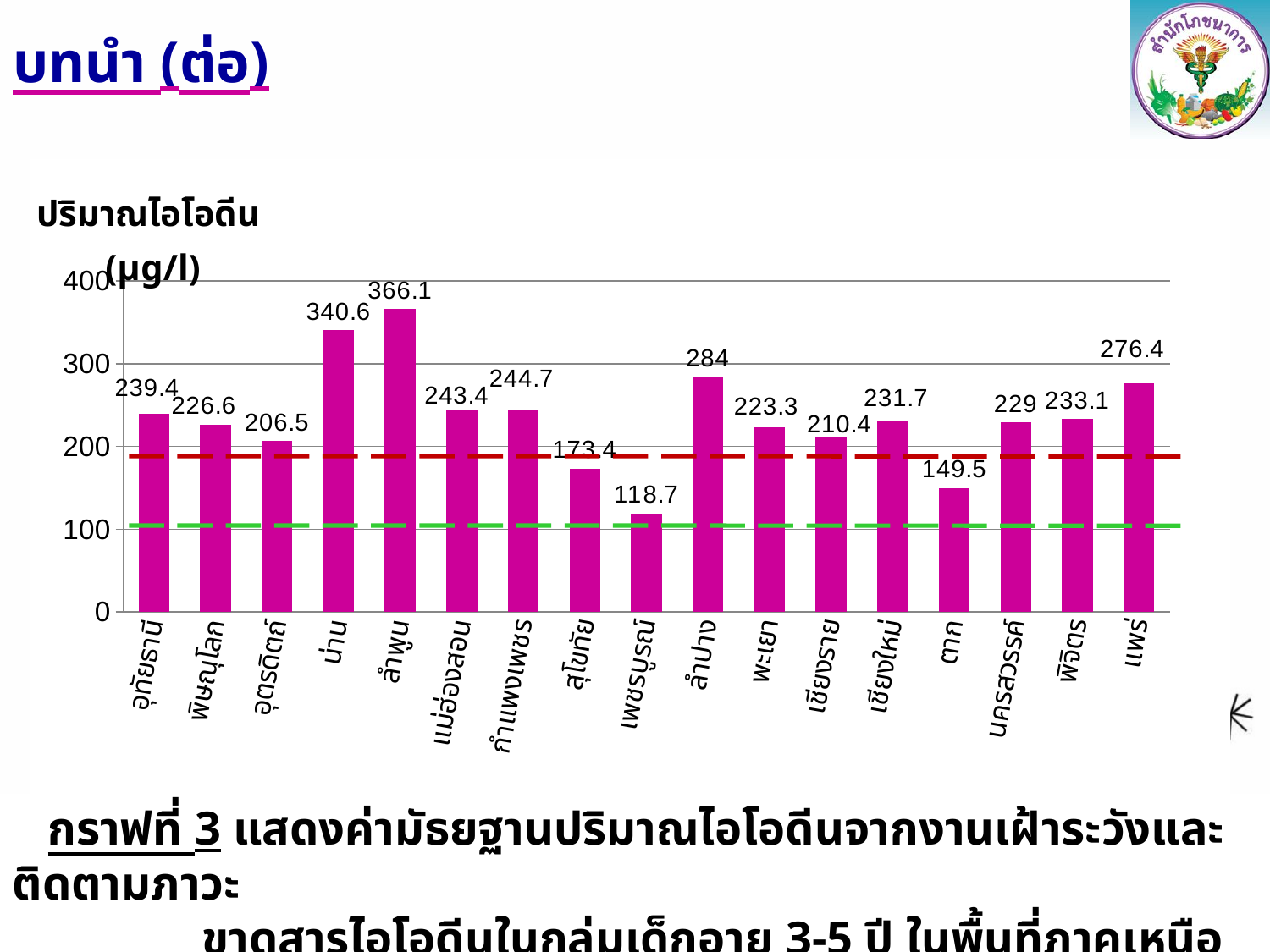
What is the value for ลำปาง? 284 How many provinces are shown on the x axis? 17 What is the value for ลำพูน? 366.1 What is the value for ตาก? 149.5 What is the value for เพชรบูรณ์? 118.7 Which province has the lowest value? เพชรบูรณ์ Is the value for อุตรดิตถ์ greater or less than 200? greater Which province has the highest value? ลำพูน What kind of chart is shown on the slide? bar chart Which is larger, the value for แพร่ or the value for เชียงใหม่? แพร่ What is the difference between the values for น่าน and สุโขทัย? 167.2 What is the label of the y axis? ปริมาณไอโอดีน (µg/l)